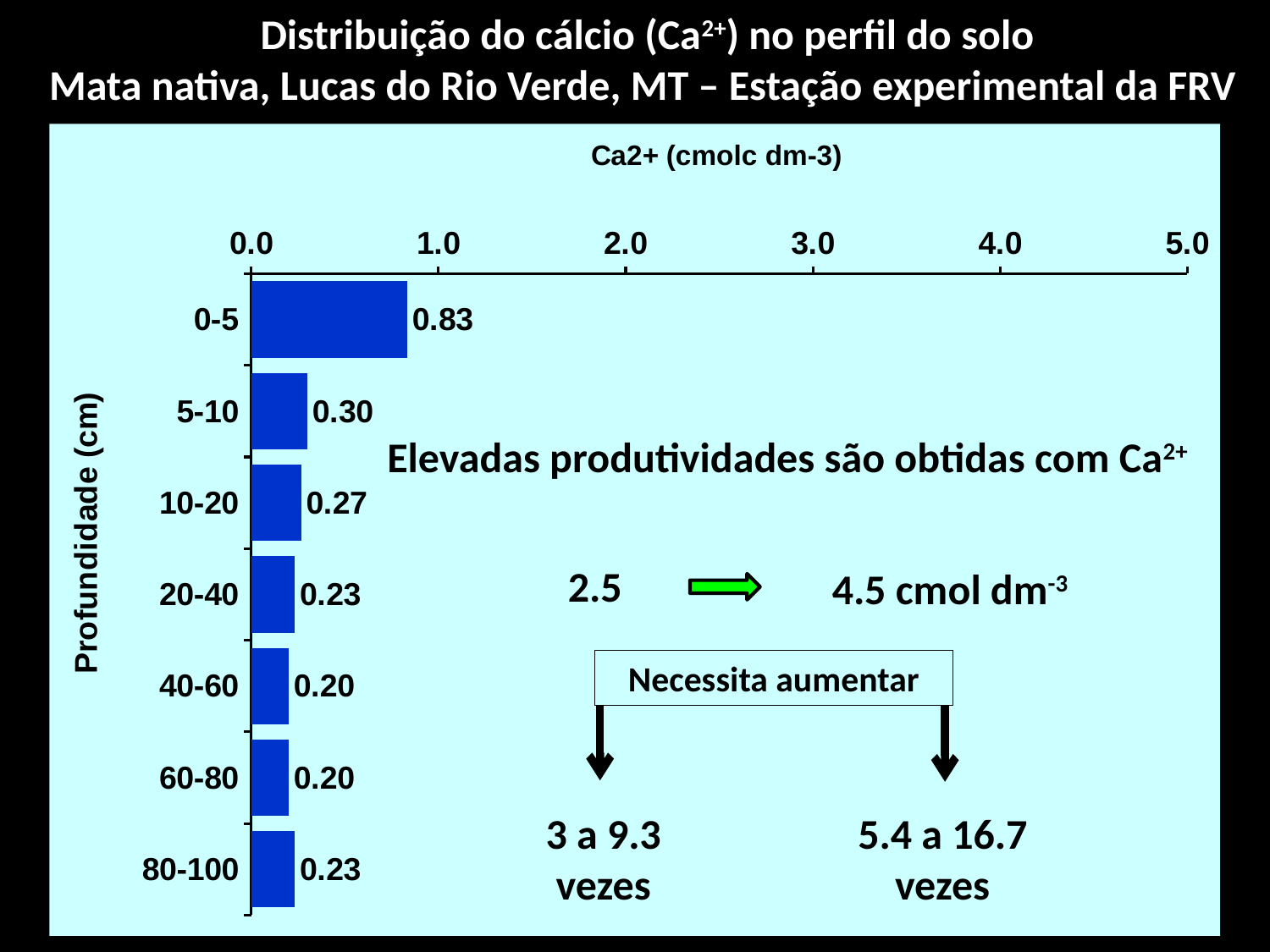
What is the Ca2+ value for the 80-100 cm depth? 0.23 What is the difference between the Ca2+ values for 0-5 cm and 5-10 cm? 0.53 What is the maximum value shown on the horizontal axis? 5.0 How many depth categories are shown in the chart? 7 What kind of chart is shown on the slide? bar chart What is the Ca2+ value for the 0-5 cm depth? 0.83 Is the Ca2+ value for 0-5 cm greater or less than 1.0? less Which depth has the highest Ca2+ value? 0-5 What is the difference between the Ca2+ values for 10-20 cm and 20-40 cm? 0.04 What is the Ca2+ value for the 40-60 cm depth? 0.20 What is the label of the vertical axis? Profundidade (cm) Which has a larger Ca2+ value, 5-10 cm or 10-20 cm? 5-10